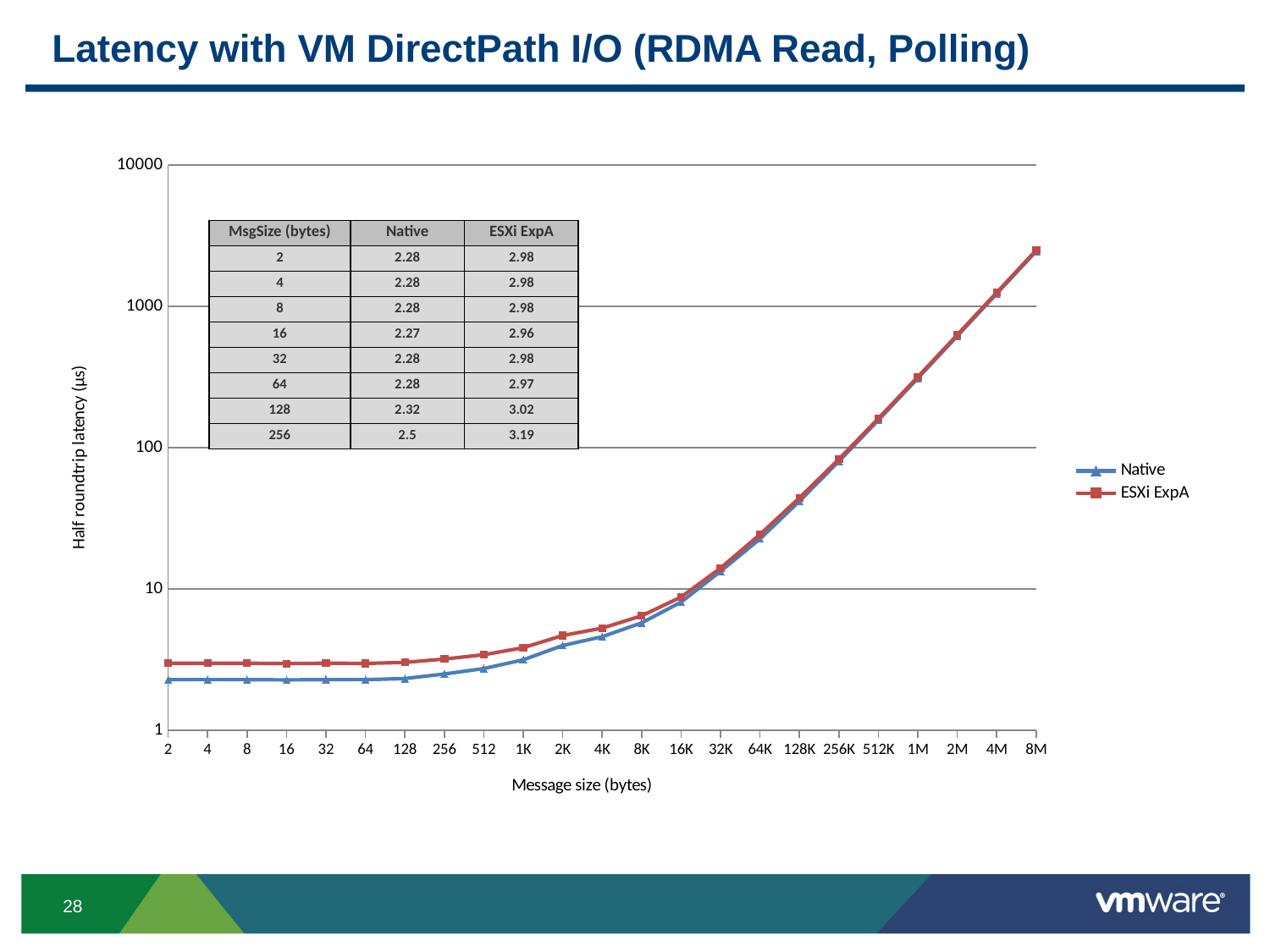
What is the difference between the ESXi ExpA and Native latencies at a message size of 2 bytes? 0.70 Is the ESXi ExpA latency at a message size of 1M greater or less than 100? greater What is the label of the y axis? Half roundtrip latency (µs) Is the Native latency at a message size of 8M greater or less than 1000? greater At a message size of 64 bytes, which series has the higher latency, Native or ESXi ExpA? ESXi ExpA According to the table, what is the ESXi ExpA latency for a message size of 128 bytes? 3.02 How many series does the legend list? 2 According to the table, what is the Native latency for a message size of 256 bytes? 2.5 Do the latency values rise or fall as message size increases along the x axis? rise What kind of chart is shown on the slide? line chart How many message sizes are shown along the x axis? 23 According to the table, what is the Native latency for a message size of 16 bytes? 2.27